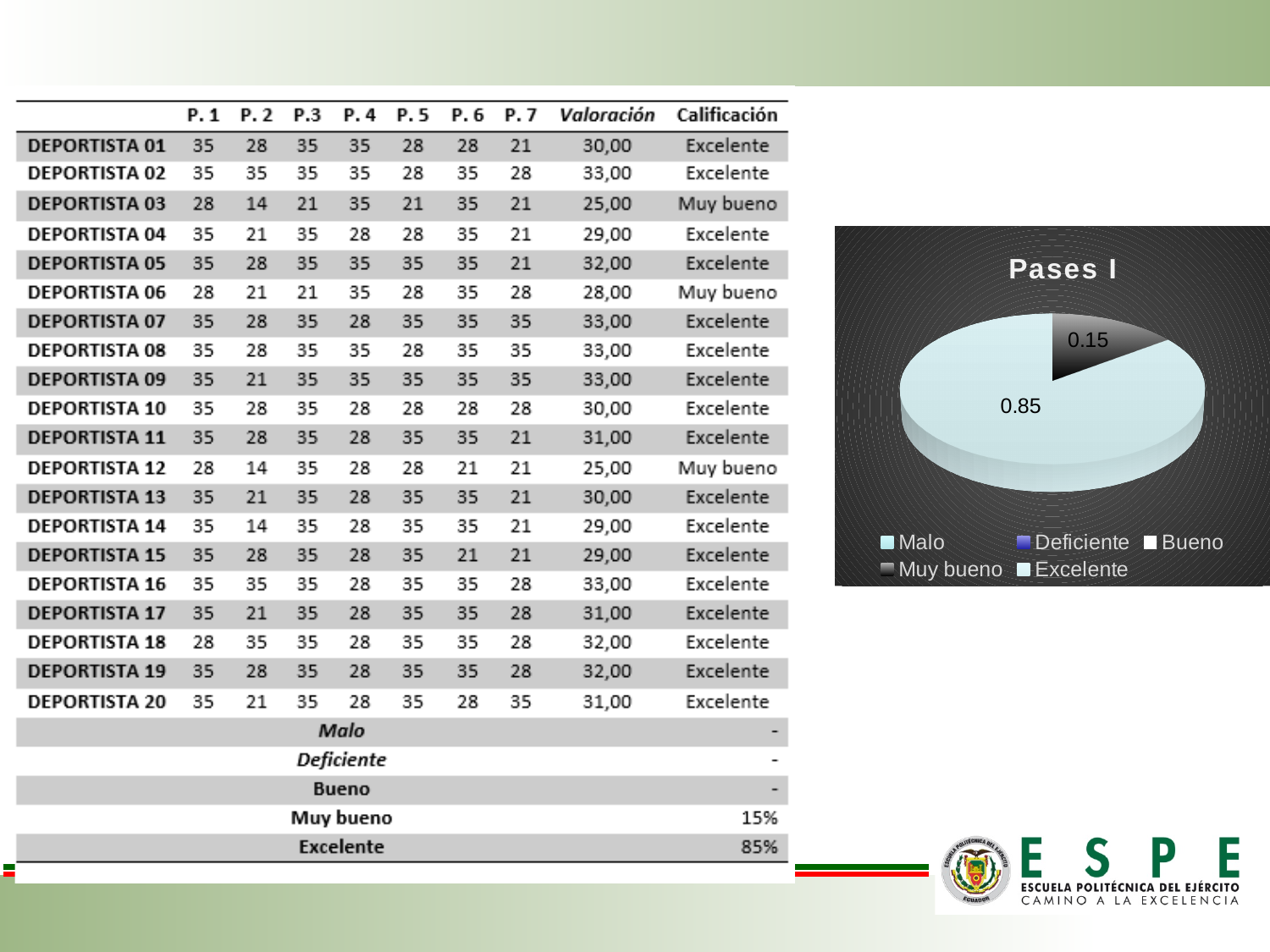
What is the title of the pie chart? Pases I In the Pases I chart, which slice is larger, Excelente or Muy bueno? Excelente In the Pases I chart, what is the difference between the Excelente and Muy bueno values? 0.70 Which legend entries of the Pases I chart are listed in the first row of the legend? Malo, Deficiente, Bueno In the Pases I chart, what is the value shown on the largest slice? 0.85 In the Pases I chart, what is the value of the Excelente slice? 0.85 What kind of chart is shown on the slide? pie chart In the Pases I chart, what is the value shown on the smaller slice? 0.15 Which category has the largest slice in the Pases I chart? Excelente How many slices with data labels are visible in the Pases I chart? 2 In the Pases I chart, what is the value of the Muy bueno slice? 0.15 How many entries does the legend of the Pases I chart list? 5